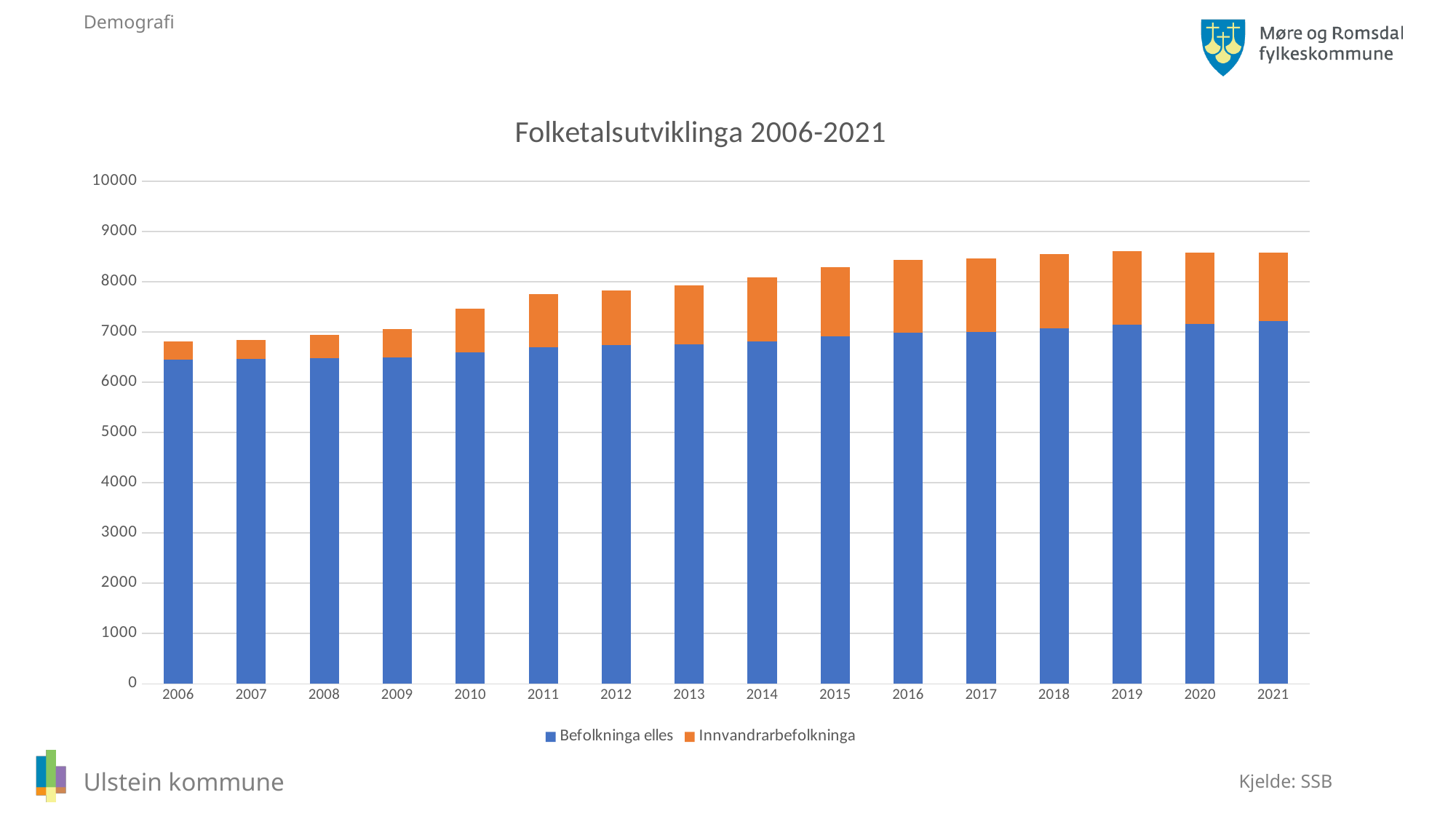
Which two series are listed in the legend? Befolkninga elles and Innvandrarbefolkninga How many years are shown on the x axis? 16 Do the total bar heights generally rise or fall from 2006 to 2021? rise What is the title of the chart? Folketalsutviklinga 2006-2021 Which year has the larger total bar, 2006 or 2021? 2021 Is the total bar height for 2021 greater or less than 8000? greater Is the total bar height for 2006 greater or less than 7000? less What kind of chart is shown on the slide? Stacked bar chart Is the value for Befolkninga elles in 2021 greater or less than 7000? greater How many series does the legend list? 2